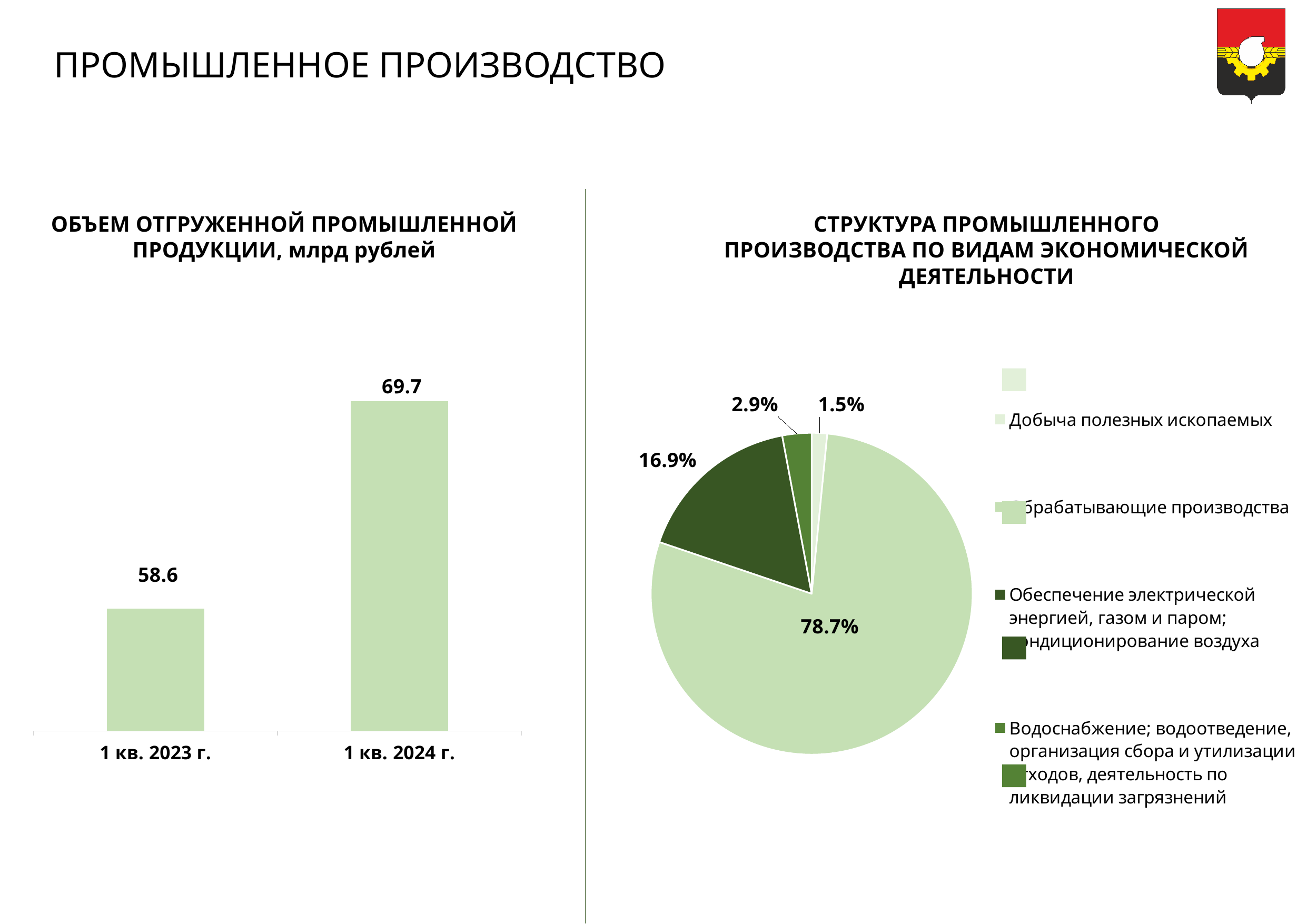
On the left bar chart, by how much does the value for 1 кв. 2024 г. exceed the value for 1 кв. 2023 г.? 11.1 On the left bar chart, which period has the higher value, 1 кв. 2023 г. or 1 кв. 2024 г.? 1 кв. 2024 г. On the left bar chart, do the values rise or fall from 1 кв. 2023 г. to 1 кв. 2024 г.? rise On the right pie chart, which category has the smallest share? Добыча полезных ископаемых How many bars are shown on the left chart 'Объем отгруженной промышленной продукции, млрд рублей'? 2 On the right pie chart, what share does 'Добыча полезных ископаемых' have? 1.5% How many categories does the legend of the right pie chart list? 4 On the left chart 'Объем отгруженной промышленной продукции, млрд рублей', what is the value for 1 кв. 2024 г.? 69.7 What kind of chart is the left chart 'Объем отгруженной промышленной продукции, млрд рублей'? bar chart On the left chart 'Объем отгруженной промышленной продукции, млрд рублей', what is the value for 1 кв. 2023 г.? 58.6 On the right pie chart, what share does 'Обеспечение электрической энергией, газом и паром; кондиционирование воздуха' have? 16.9% On the right pie chart 'Структура промышленного производства по видам экономической деятельности', what share does 'Обрабатывающие производства' have? 78.7%